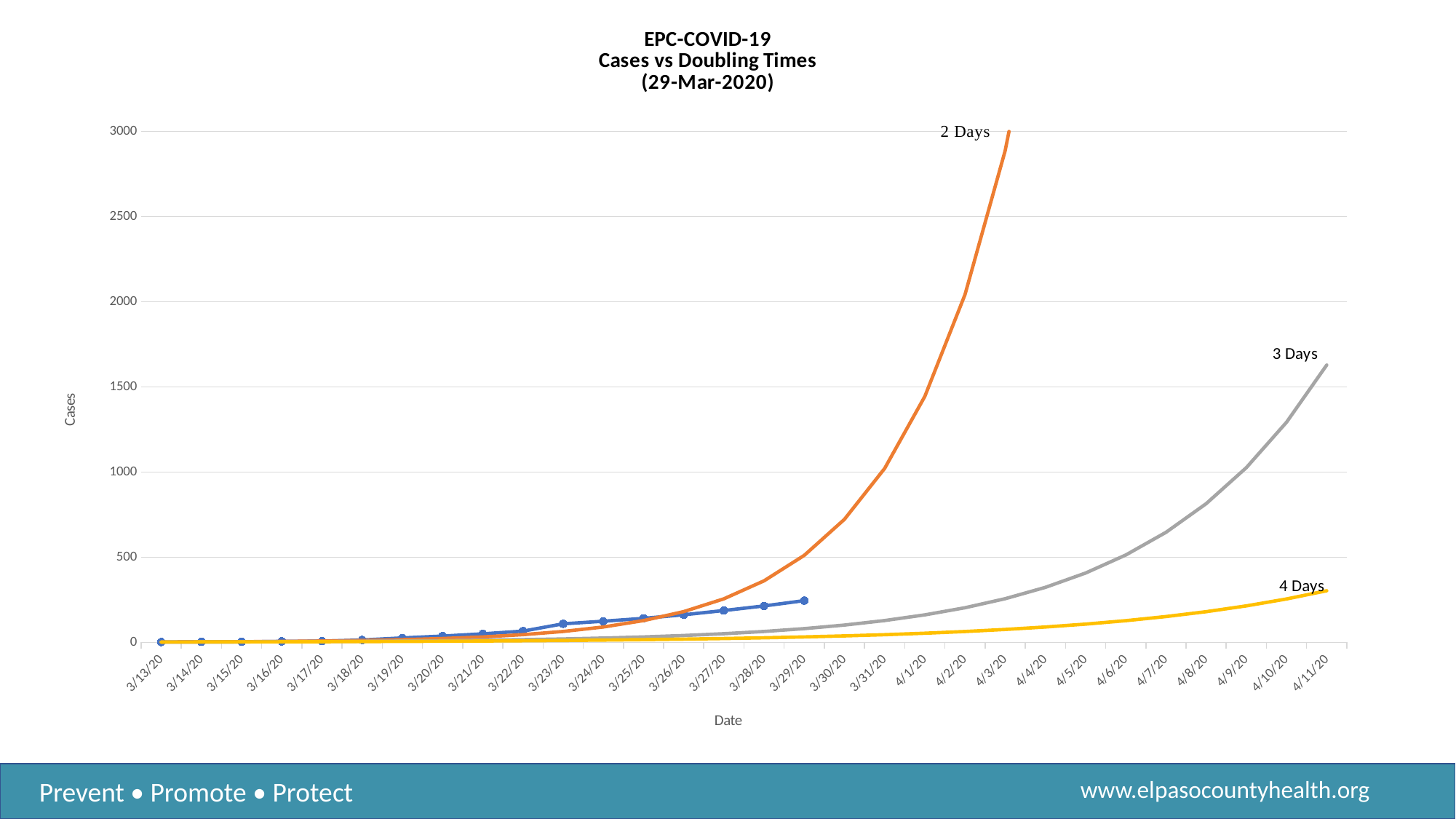
What kind of chart is shown on the slide? Line chart How many doubling-time curves are labeled on the chart? 3 What is the title of the chart? EPC-COVID-19 Cases vs Doubling Times (29-Mar-2020) What is the label on the vertical axis of the chart? Cases Which curve reaches the highest value on the chart? 2 Days On 4/11/20, which curve is higher: 3 Days or 4 Days? 3 Days Is the value of the 4 Days curve on 4/11/20 greater or less than 500? less How many dates are shown along the x axis of the chart? 30 Does the 2 Days curve rise or fall as the dates move from left to right? Rise Is the value of the blue cases line on 3/29/20 greater or less than 500? less Is the value of the 2 Days curve on 4/2/20 greater or less than 1500? greater